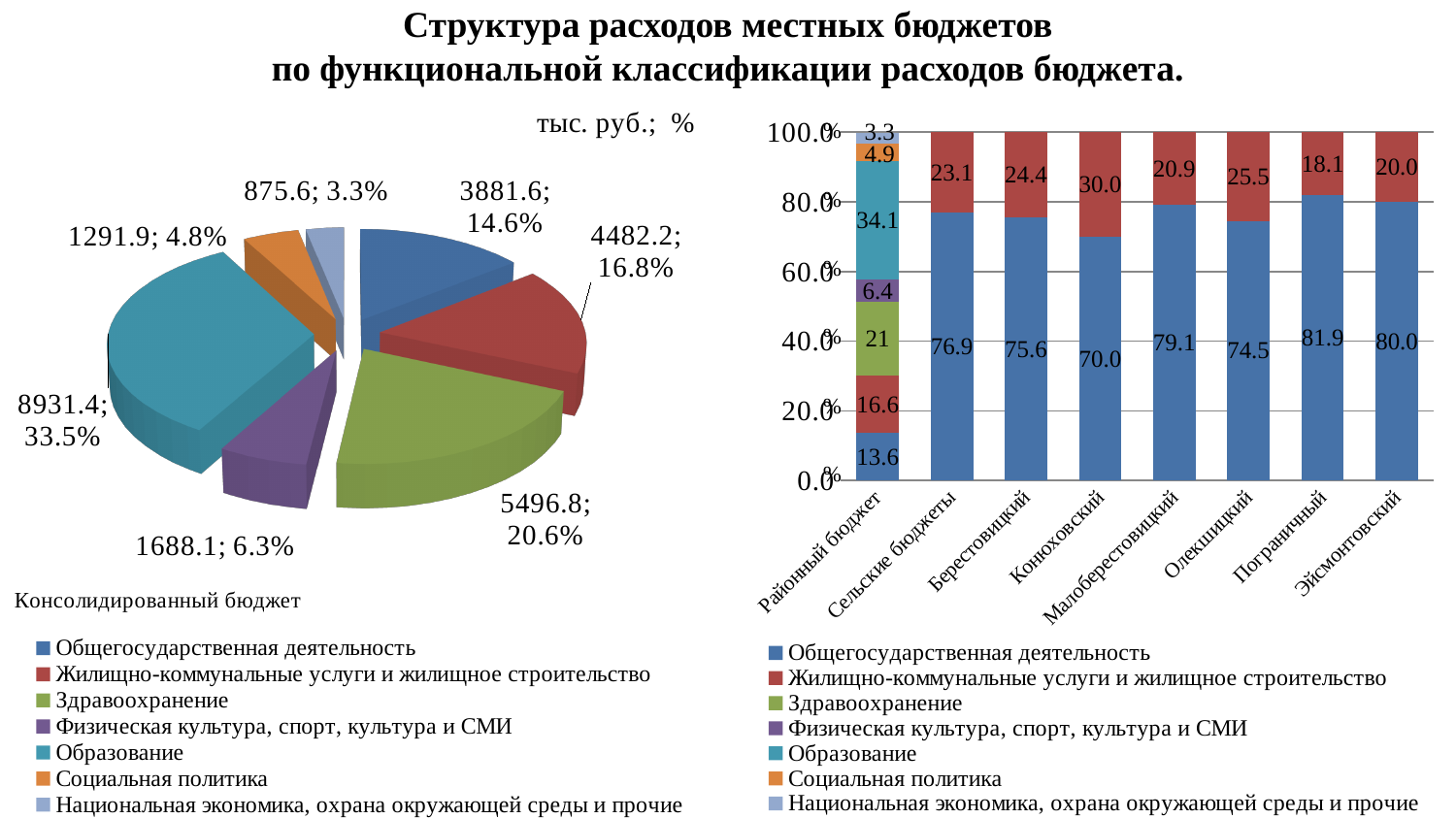
On the right bar chart, what is the value of Общегосударственная деятельность for Пограничный? 81.9 What type of chart is on the right side of the slide? Stacked bar chart On the right bar chart, how many categories are shown on the x axis? 8 On the right bar chart, which is larger: Общегосударственная деятельность for Эйсмонтовский or for Олекшицкий? Эйсмонтовский On the left pie chart, which category has the smallest share? Национальная экономика, охрана окружающей среды и прочие On the right bar chart, which budget has the highest value for Жилищно-коммунальные услуги и жилищное строительство? Конюховский On the left pie chart, what is the difference in percentage points between Жилищно-коммунальные услуги и жилищное строительство (16.8%) and Общегосударственная деятельность (14.6%)? 2.2 On the left pie chart, what percentage share does Здравоохранение have? 20.6% On the left pie chart, which category has the largest share? Образование On the left pie chart, how many slices are there? 7 On the right bar chart, what is the value of Образование for Районный бюджет? 34.1 On the left pie chart (Консолидированный бюджет), what value is shown for Образование? 8931.4; 33.5%